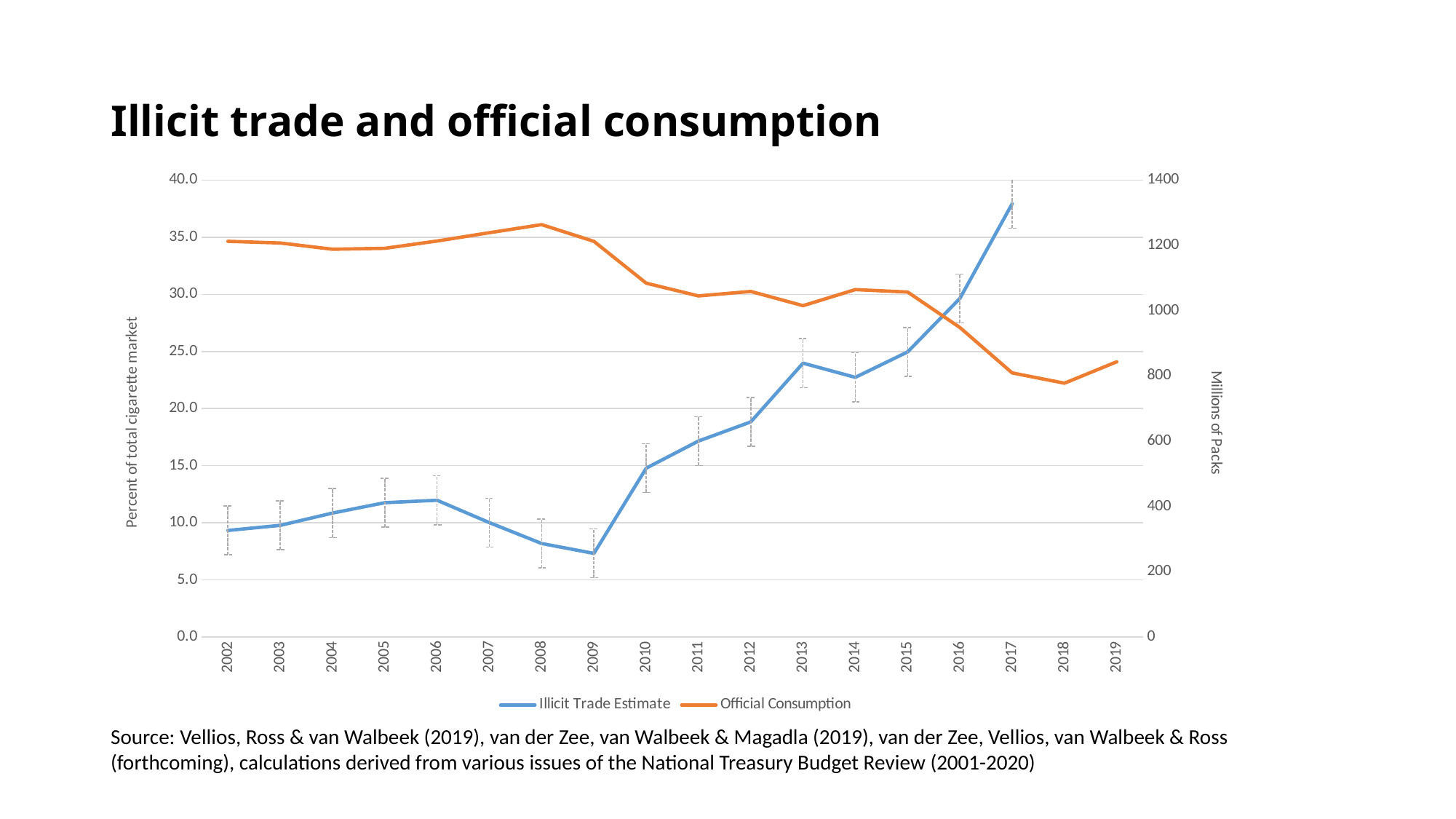
How many years are plotted along the x axis? 18 Is the Illicit Trade Estimate for 2009 greater or less than 10? less In which year is Official Consumption at its highest? 2008 Is the Illicit Trade Estimate for 2017 greater or less than 35? greater Which year has the larger Official Consumption, 2008 or 2019? 2008 Does the Illicit Trade Estimate rise or fall between 2009 and 2017? rise What is the label of the right-hand vertical axis? Millions of Packs In which year does the Illicit Trade Estimate reach its highest value? 2017 Is Official Consumption in 2019 greater or less than 1000 million packs? less In which year is the Illicit Trade Estimate at its lowest? 2009 How many series does the legend list? 2 What kind of chart is shown on the slide? Line chart